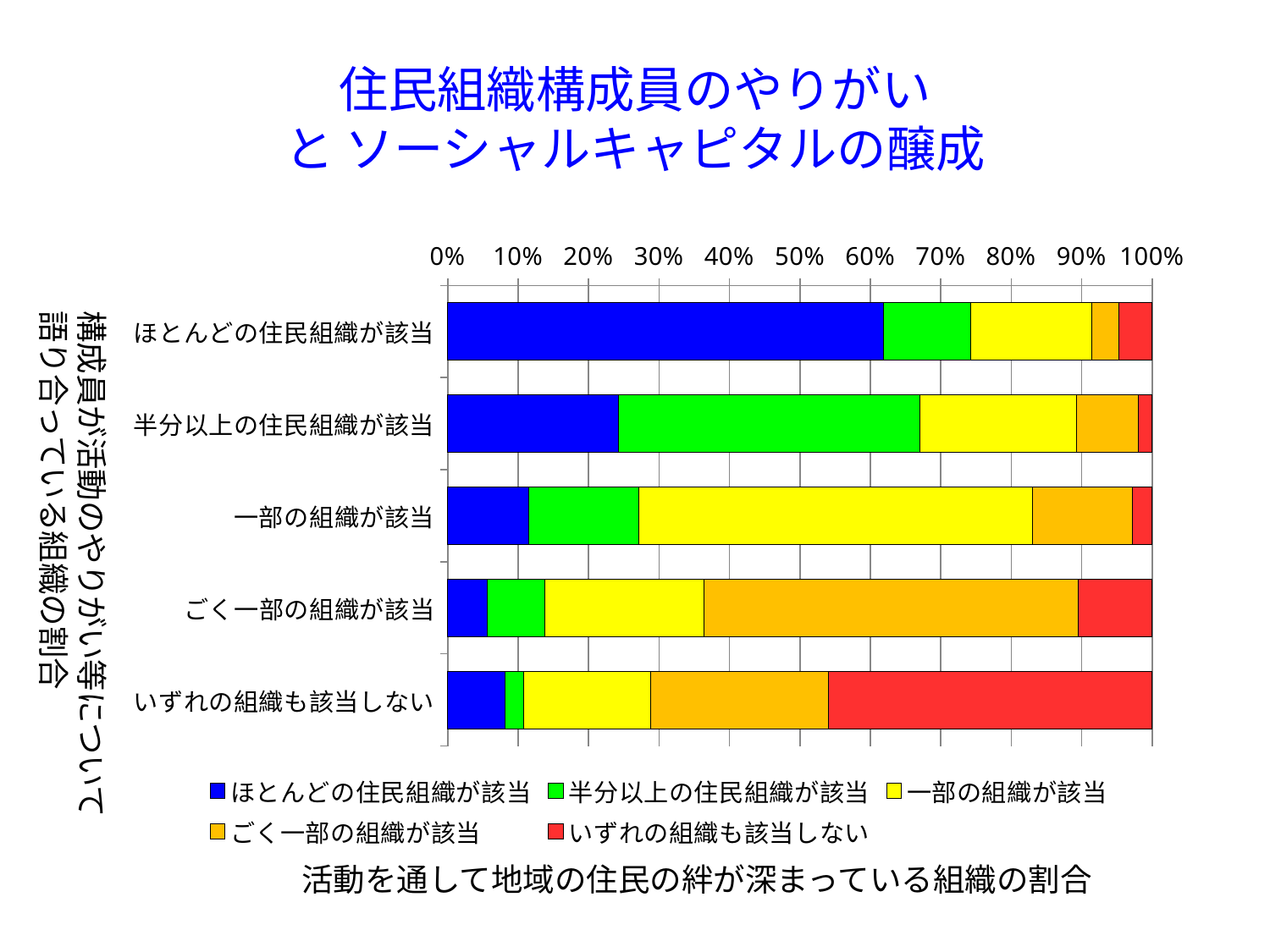
Which category has the larger green (半分以上の住民組織が該当) segment: 半分以上の住民組織が該当 or いずれの組織も該当しない? 半分以上の住民組織が該当 How many series does the chart legend list? 5 Is the yellow (一部の組織が該当) segment for the category 一部の組織が該当 greater or less than 50%? greater What is the title of the slide? 住民組織構成員のやりがい と ソーシャルキャピタルの醸成 Is the blue (ほとんどの住民組織が該当) segment for the category ほとんどの住民組織が該当 greater or less than 50%? greater Is the red (いずれの組織も該当しない) segment for the category いずれの組織も該当しない greater or less than 40%? greater Which category has the largest blue (ほとんどの住民組織が該当) segment? ほとんどの住民組織が該当 What colour represents the series ごく一部の組織が該当 in the legend? Orange How many categories are plotted on the vertical axis of the chart? 5 What kind of chart is shown on the slide? Stacked bar chart Which category has the largest red (いずれの組織も該当しない) segment? いずれの組織も該当しない